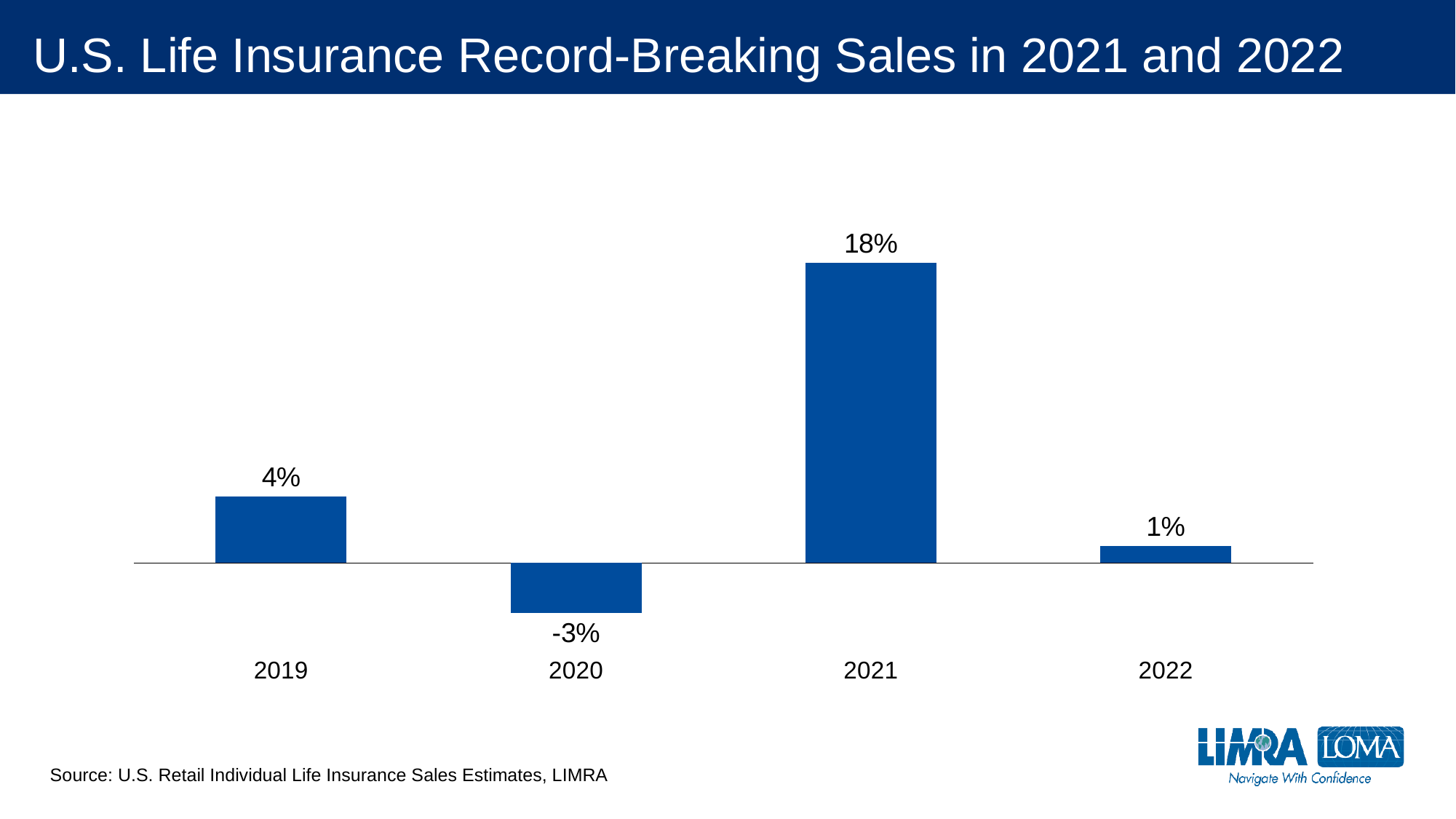
Which year has the highest value? 2021 How many years are shown on the chart? 4 Which is larger, the value for 2019 or the value for 2022? 2019 What is the title of the slide? U.S. Life Insurance Record-Breaking Sales in 2021 and 2022 What is the value shown for 2020? -3% What is the value shown for 2021? 18% What is the value shown for 2019? 4% What is the difference between the values for 2021 and 2019? 14% What is the value shown for 2022? 1% What kind of chart is shown on the slide? Bar chart Which year has the lowest value? 2020 What is the difference between the values for 2019 and 2020? 7%